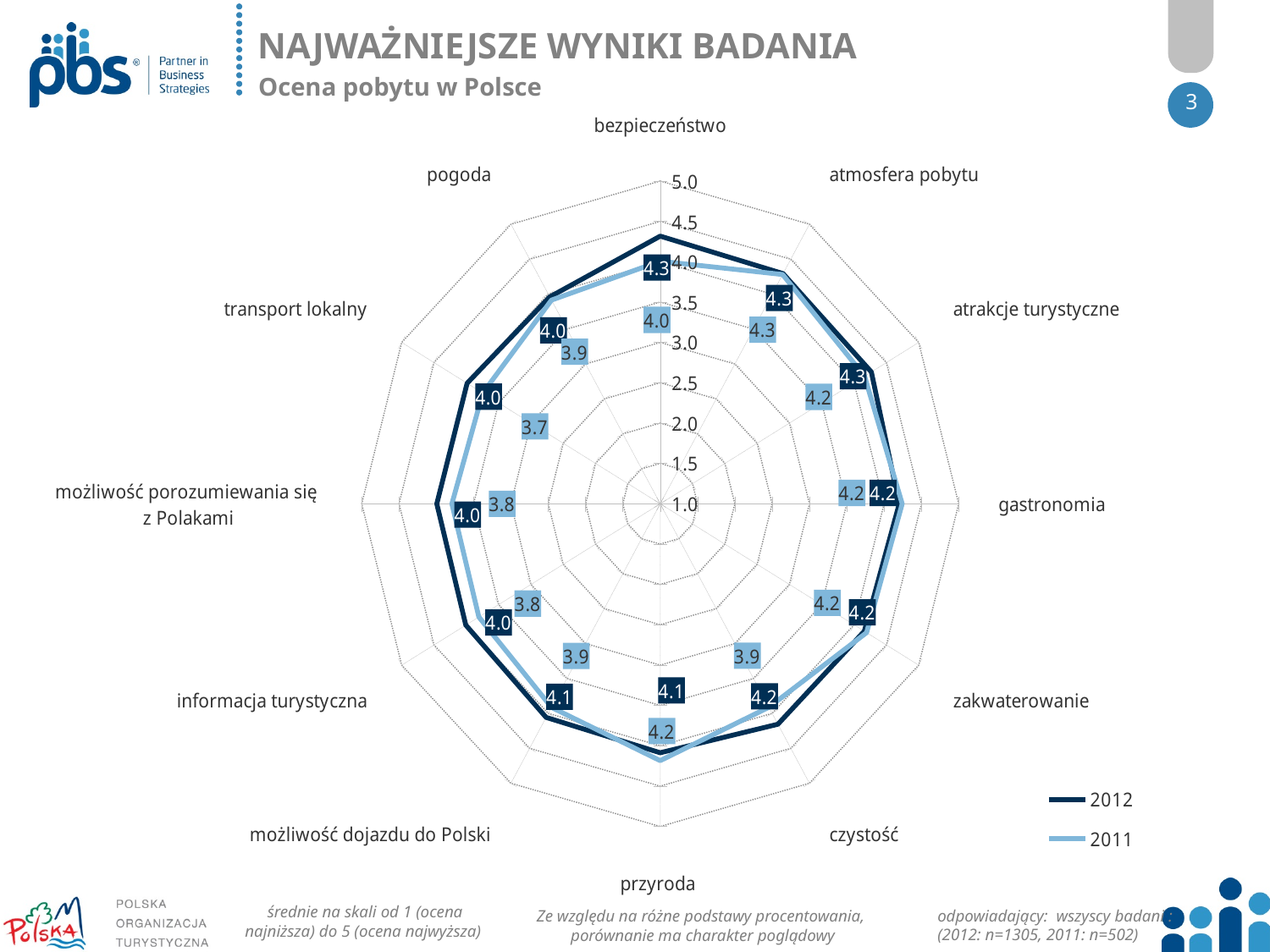
How many series does the legend list? 2 What is the 2011 value for czystość? 3.9 What is the 2012 value for informacja turystyczna? 4.0 What is the 2011 value for transport lokalny? 3.7 Which series is drawn with the dark navy line? 2012 Which is larger for przyroda: the 2012 value or the 2011 value? 2011 How many categories (axes) does the radar chart have? 12 Which category has the lowest 2011 value? transport lokalny What type of chart is shown on the slide? radar chart What is the difference between the 2012 and 2011 values for bezpieczeństwo? 0.3 What is the 2012 value for bezpieczeństwo? 4.3 What is the difference between the 2012 and 2011 values for transport lokalny? 0.3